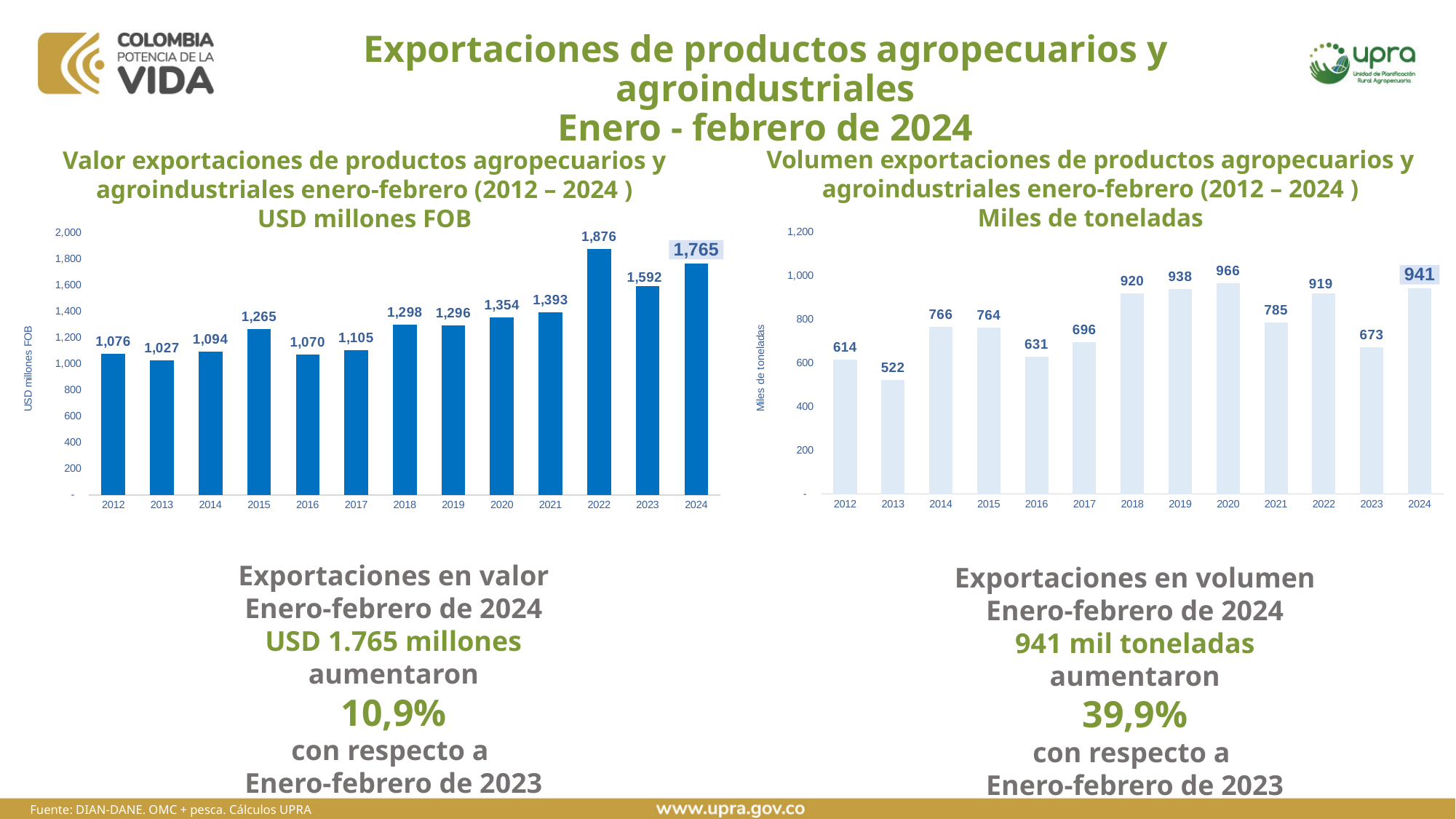
In the right chart (Volumen exportaciones, Miles de toneladas), which year has the lowest value? 2013 In the left chart (Valor exportaciones, USD millones FOB), how many years are plotted? 13 In the left chart (Valor exportaciones, USD millones FOB), what is the difference between the 2024 value and the 2023 value? 173 In the right chart (Volumen exportaciones, Miles de toneladas), which year has the highest value? 2020 In the right chart (Volumen exportaciones, Miles de toneladas), what is the difference between the 2024 value and the 2023 value? 268 In the right chart (Volumen exportaciones, Miles de toneladas), what is the value for 2013? 522 What type of chart is the left chart (Valor exportaciones, USD millones FOB)? Bar chart In the right chart (Volumen exportaciones, Miles de toneladas), which is larger, the value for 2018 or the value for 2022? 2018 In the left chart (Valor exportaciones, USD millones FOB), what is the value for 2024? 1,765 In the left chart (Valor exportaciones, USD millones FOB), is the value for 2021 greater or less than 1,400? less In the left chart (Valor exportaciones, USD millones FOB), which year has the highest value? 2022 In the left chart (Valor exportaciones, USD millones FOB), which year has the lowest value? 2013